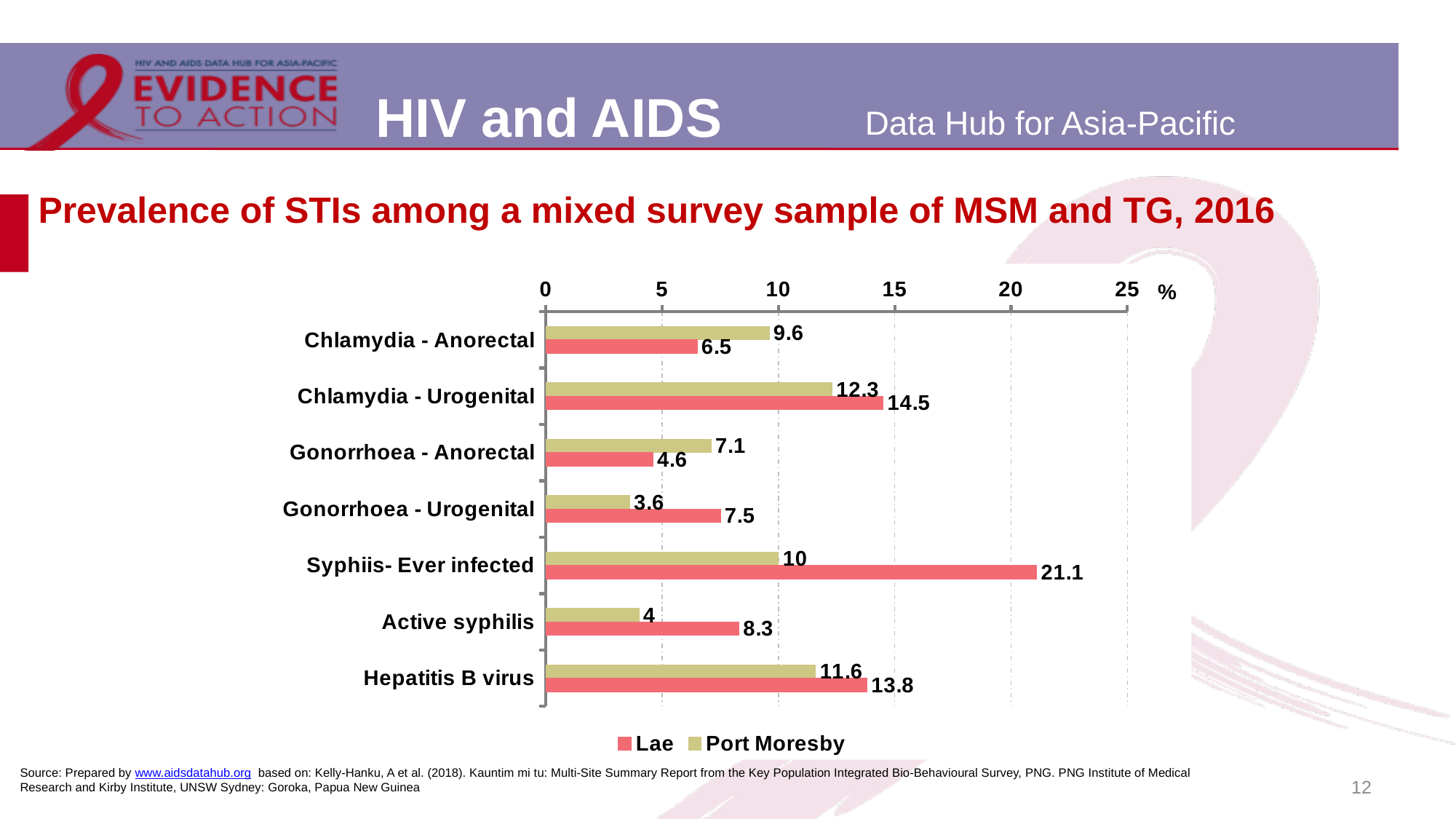
What kind of chart is shown on the slide? Bar chart For Active syphilis, which is larger, the Lae value or the Port Moresby value? Lae For Chlamydia - Anorectal, which is larger, the Lae value or the Port Moresby value? Port Moresby What is the difference between the Lae and Port Moresby values for Syphiis- Ever infected? 11.1 Which category has the highest value for Lae? Syphiis- Ever infected Which colour represents Port Moresby in the chart? Olive/khaki What is the prevalence of Chlamydia - Anorectal for Port Moresby? 9.6 Which category has the lowest value for Port Moresby? Gonorrhoea - Urogenital What is the prevalence of Hepatitis B virus for Lae? 13.8 How many STI categories are shown on the chart? 7 How many series does the legend list? 2 What is the prevalence of Syphiis- Ever infected for Lae? 21.1